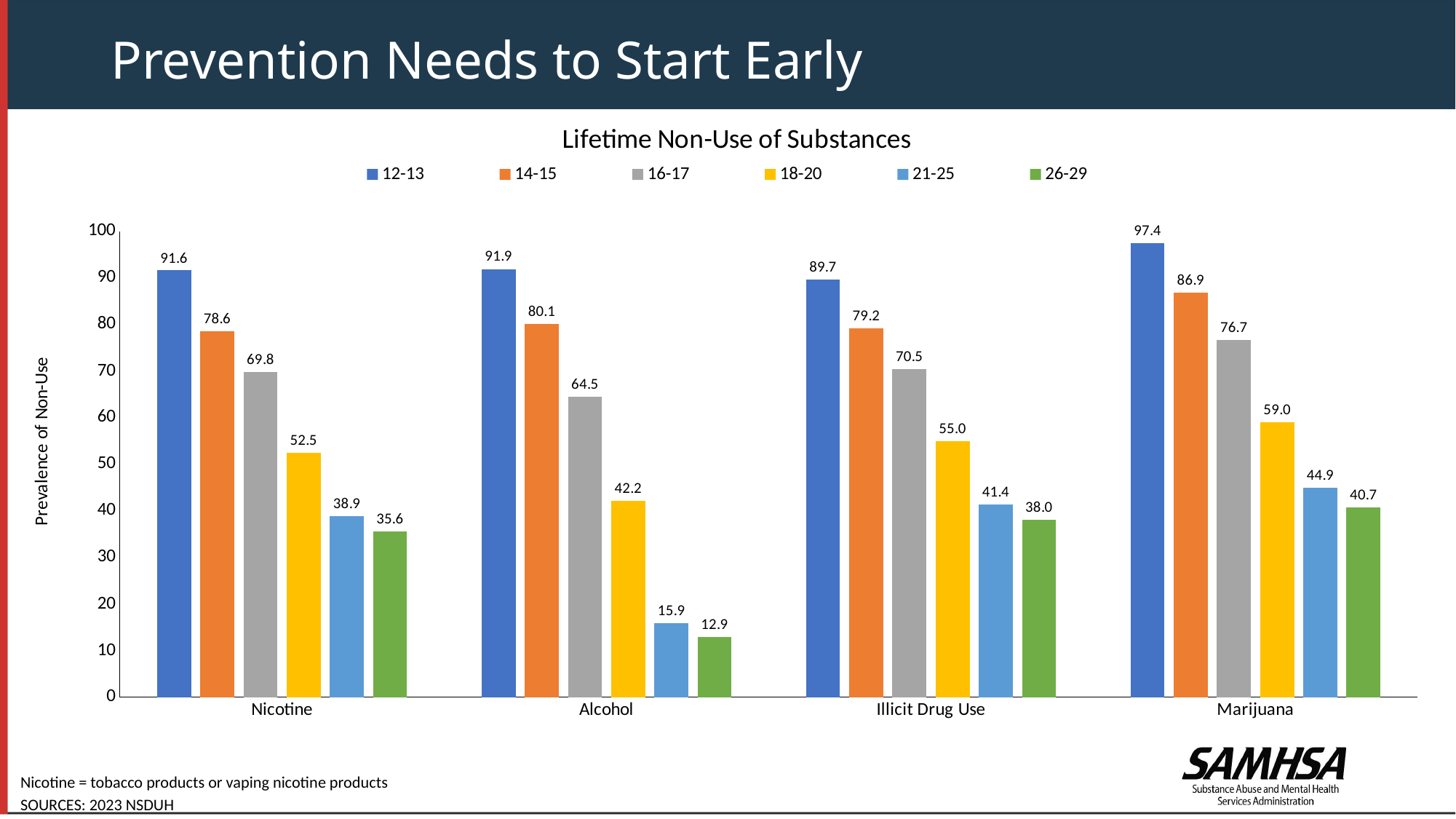
Within each substance, do the values rise or fall as the age group gets older? Fall How many substance categories are shown on the x axis? 4 What kind of chart is shown on the slide? Bar chart How many age groups does the legend list? 6 What is the value for the 12-13 age group for Nicotine? 91.6 Which is larger: the 21-25 value for Nicotine or the 21-25 value for Marijuana? Marijuana Which substance has the highest value for the 12-13 age group? Marijuana Which substance has the lowest value for the 26-29 age group? Alcohol What is the difference between the 12-13 and 26-29 values for Illicit Drug Use? 51.7 What is the value for the 18-20 age group for Marijuana? 59.0 What is the title of the chart? Lifetime Non-Use of Substances What is the value for the 26-29 age group for Alcohol? 12.9